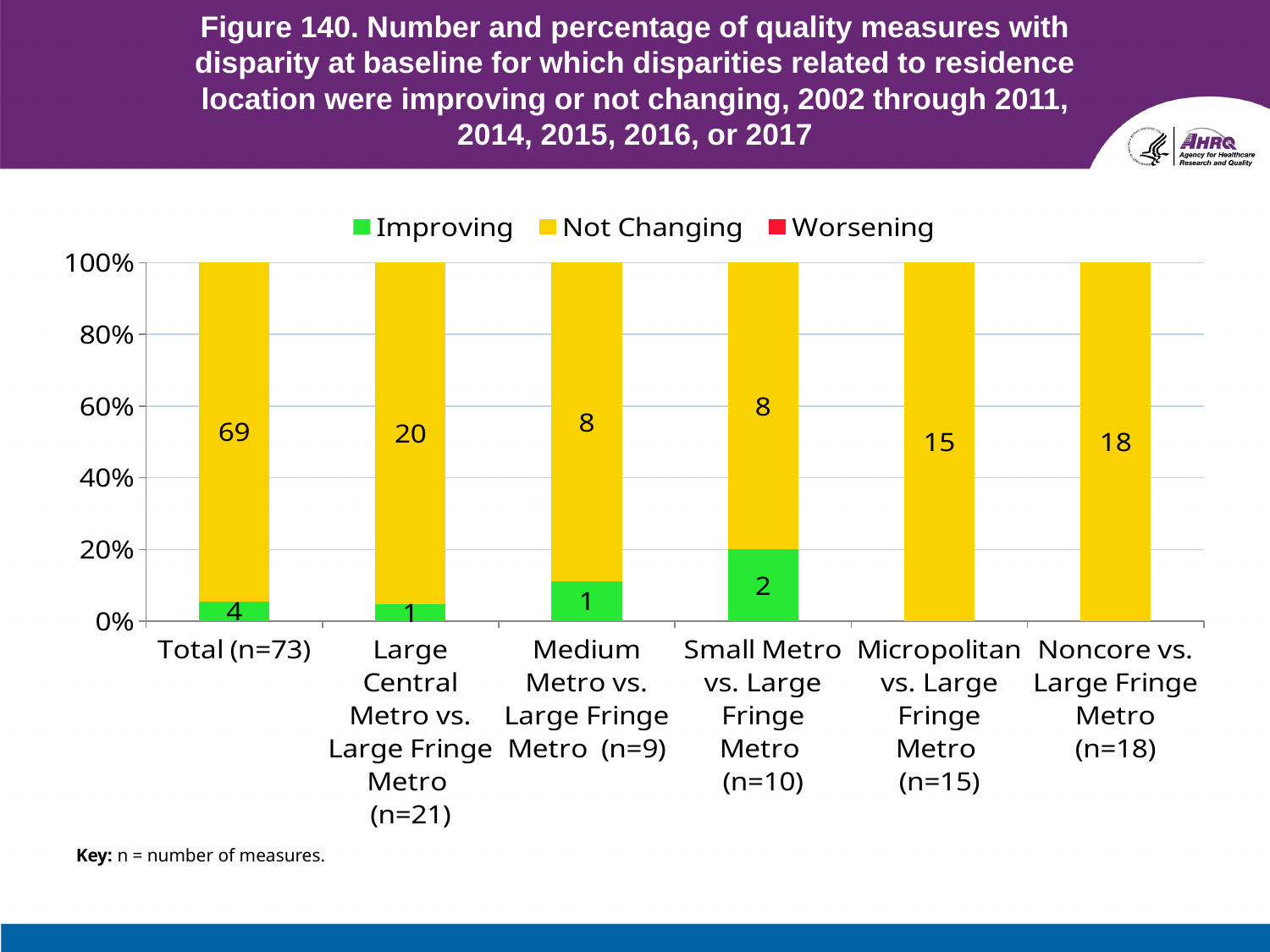
Excluding Total, which category has the highest number of Improving measures? Small Metro vs. Large Fringe Metro (n=10) What is the difference between the Not Changing counts for Noncore vs. Large Fringe Metro and Micropolitan vs. Large Fringe Metro? 3 Which is larger: the Not Changing count for Large Central Metro vs. Large Fringe Metro or for Noncore vs. Large Fringe Metro? Large Central Metro vs. Large Fringe Metro What is the number of Improving measures for Large Central Metro vs. Large Fringe Metro (n=21)? 1 How many series does the legend list? 3 How many categories are shown on the x axis? 6 Which category has the highest number of Not Changing measures? Total (n=73) What is the number of Not Changing measures for Total (n=73)? 69 What is the number of Not Changing measures for Micropolitan vs. Large Fringe Metro (n=15)? 15 What kind of chart is shown on the slide? Stacked bar chart What is the number of Improving measures for Small Metro vs. Large Fringe Metro (n=10)? 2 Is the Not Changing share of the Total (n=73) bar greater or less than 80%? greater